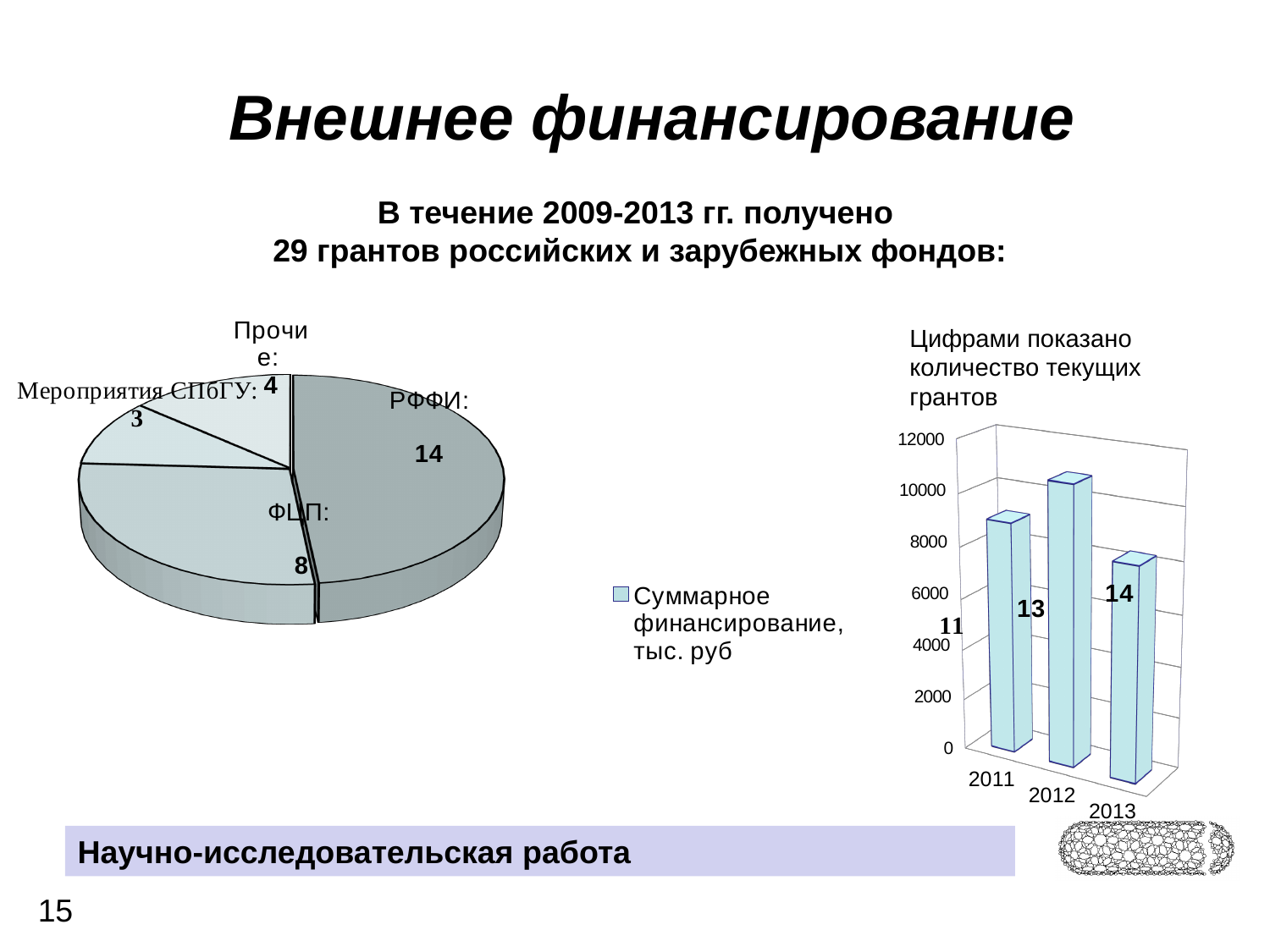
In the pie chart on the left, what is the difference between the values for РФФИ and ФЦП? 6 In the pie chart on the left, which category has the largest slice? РФФИ In the pie chart on the left, which category has the smallest slice? Мероприятия СПбГУ In the pie chart on the left, what value is shown for РФФИ? 14 In the bar chart on the right, which year has the shortest bar? 2013 In the pie chart on the left, what value is shown for Мероприятия СПбГУ? 3 In the bar chart on the right, is the value for 2011 greater or less than 8000? greater In the bar chart on the right, what series does the legend list? Суммарное финансирование, тыс. руб What kind of chart is the chart on the right of the slide? bar chart In the bar chart on the right, which year has the tallest bar? 2012 How many slices does the pie chart on the left have? 4 In the pie chart on the left, what value is shown for ФЦП? 8